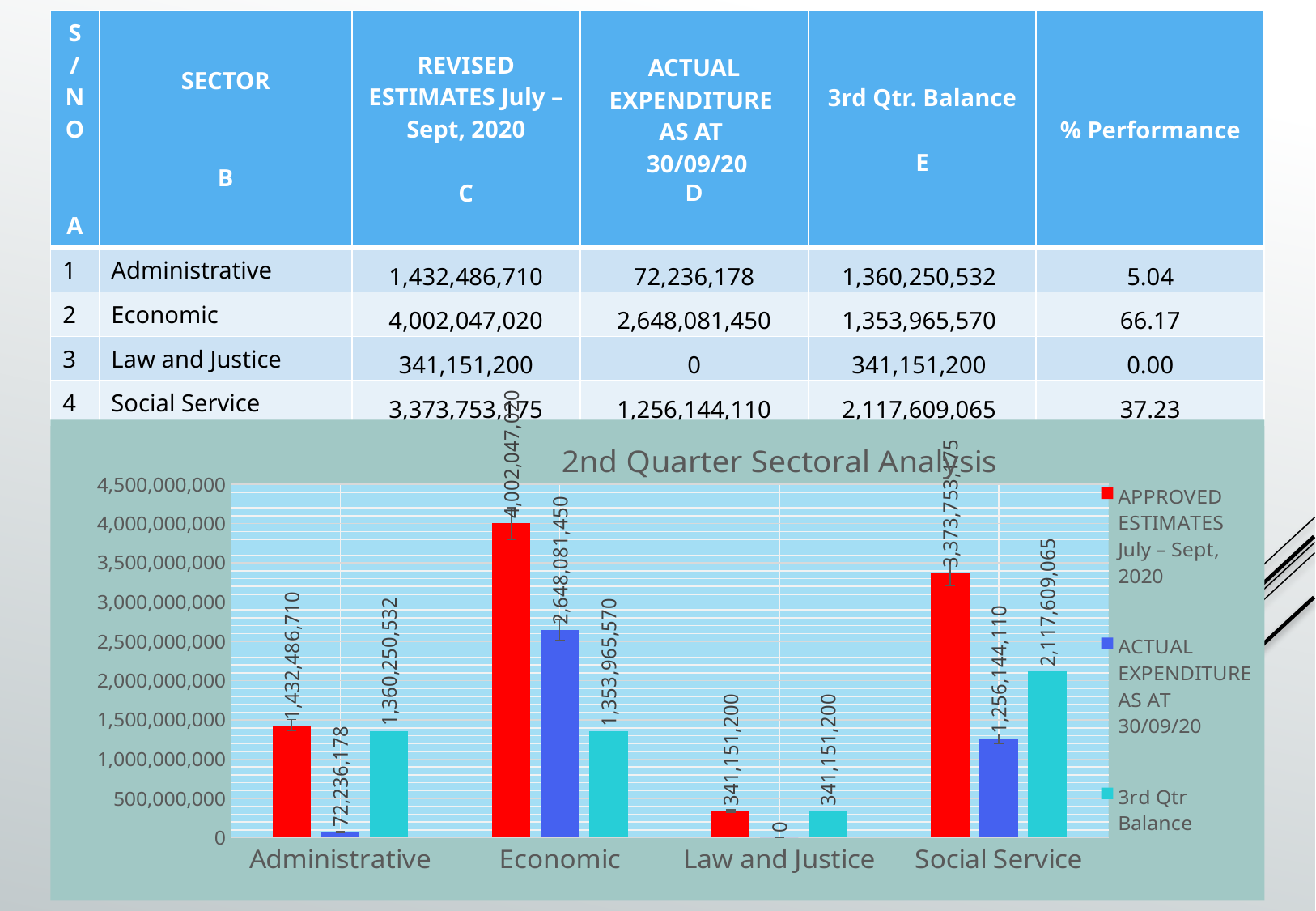
What kind of chart is shown on the slide? bar chart What is the Actual Expenditure as at 30/09/20 for the Economic sector in the chart? 2,648,081,450 What is the Actual Expenditure as at 30/09/20 for Law and Justice in the chart? 0 Which sector has the highest Approved Estimates July – Sept, 2020 in the chart? Economic How many sectors are shown on the x axis of the chart? 4 Is the Approved Estimates value for Social Service greater or less than 3,000,000,000? greater How many series does the legend of the chart list? 3 Which sector has the lowest Actual Expenditure as at 30/09/20 in the chart? Law and Justice In the chart, what is the difference between the Approved Estimates and the Actual Expenditure for the Administrative sector? 1,360,250,532 What is the 3rd Qtr Balance for Social Service in the chart? 2,117,609,065 What is the title of the chart? 2nd Quarter Sectoral Analysis In the chart, which is larger: the Actual Expenditure for Economic or for Social Service? Economic